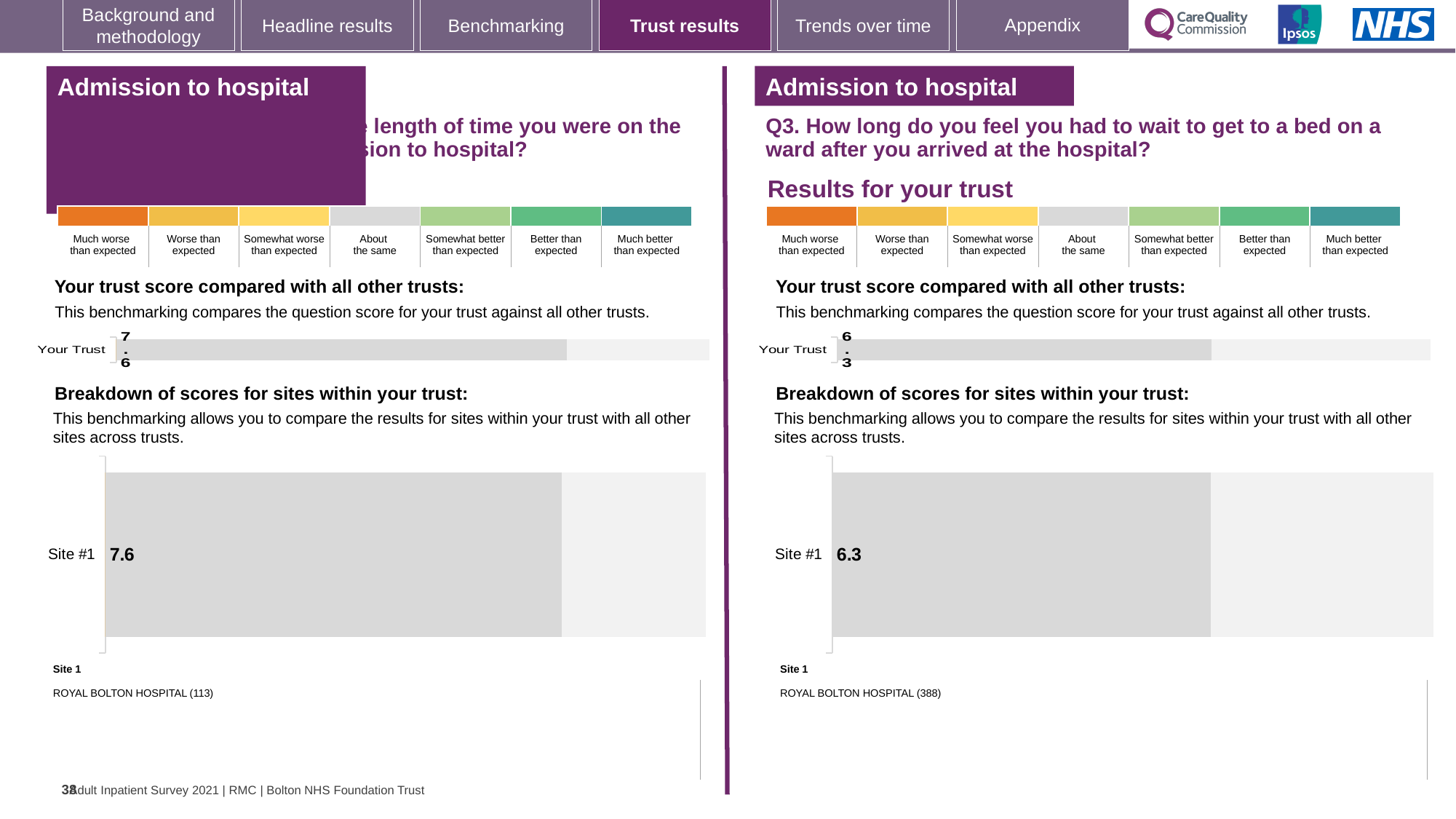
On the right panel (Q3), what is the score shown for Your Trust in the trust score comparison chart? 6.3 Is the Your Trust score on the right panel (Q3) greater or less than the Your Trust score on the left panel? less On the left panel, which hospital is listed as Site 1 below the breakdown chart? ROYAL BOLTON HOSPITAL (113) How many sites are shown in the breakdown of scores chart on the left panel? 1 How many sites are shown in the breakdown of scores chart on the right panel (Q3)? 1 On the right panel (Q3), which hospital is listed as Site 1 below the breakdown chart? ROYAL BOLTON HOSPITAL (388) On the left panel, what is the score shown for Your Trust in the trust score comparison chart? 7.6 Which is larger: the Site #1 score on the left panel or the Site #1 score on the right panel (Q3)? Left panel (7.6) What is the difference between the Site #1 score on the left panel and the Site #1 score on the right panel (Q3)? 1.3 What kind of chart is used to show the breakdown of scores for sites within your trust on the right panel (Q3)? Bar chart On the left panel, what is the score shown for Site #1 in the breakdown of scores for sites within your trust? 7.6 On the right panel (Q3), what is the score shown for Site #1 in the breakdown of scores for sites within your trust? 6.3